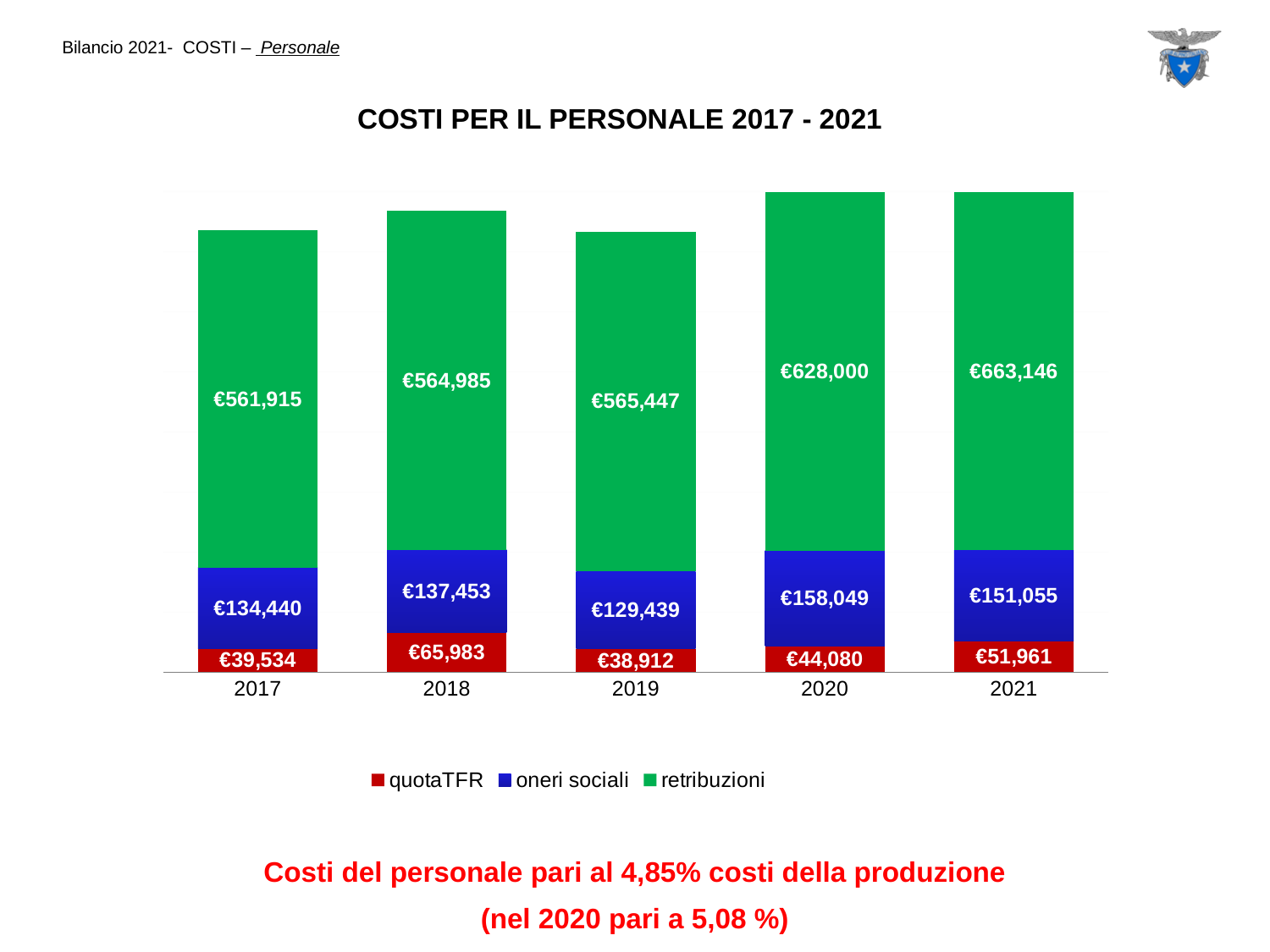
What type of chart is shown on the slide? stacked bar chart In which year is oneri sociali highest? 2020 In which year is quotaTFR lowest? 2019 Which is larger, the oneri sociali value for 2020 or for 2021? 2020 How many series does the legend list? 3 In which year is quotaTFR highest? 2018 What is the oneri sociali value for 2019? €129,439 How many years are shown on the x axis? 5 What is the retribuzioni value for 2021? €663,146 What is the quotaTFR value for 2018? €65,983 What is the total of the stacked bar for 2021? €866,162 What is the difference between the retribuzioni values for 2021 and 2020? €35,146